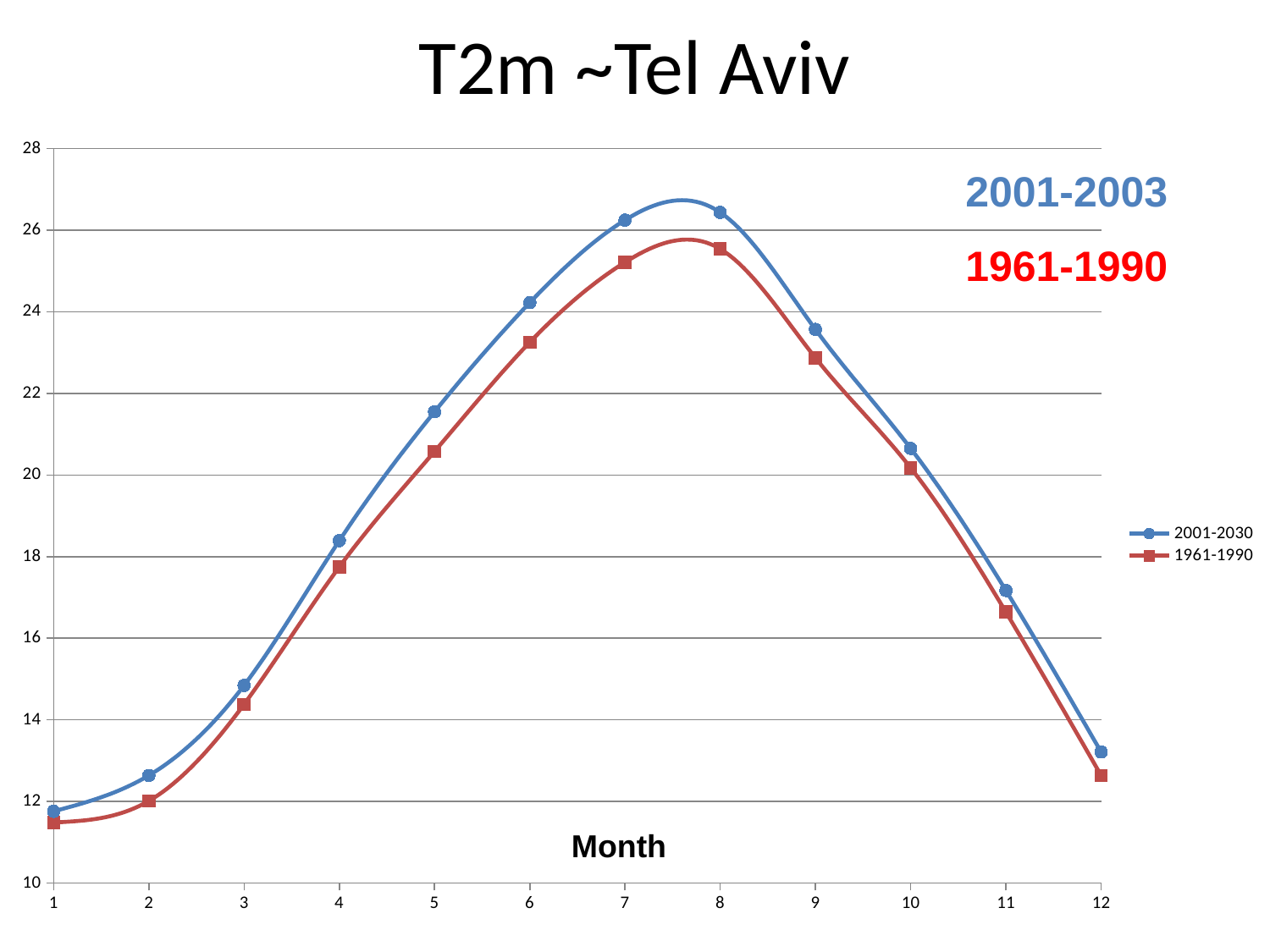
What is the title of the x axis? Month Is the value for the 1961-1990 series in month 9 greater or less than 22? greater In which month does the 2001-2030 series reach its lowest value? 1 In month 7, which series has the larger value, 2001-2030 or 1961-1990? 2001-2030 Do the values of the 2001-2030 series rise or fall from month 8 to month 12? fall Is the value for the 2001-2030 series in month 11 greater or less than 18? less In which month does the 1961-1990 series reach its lowest value? 1 How many months are plotted along the x axis? 12 Is the value for the 2001-2030 series in month 5 greater or less than 20? greater In which month does the 1961-1990 series reach its highest value? 8 What kind of chart is shown on the slide? line chart How many series does the legend list? 2